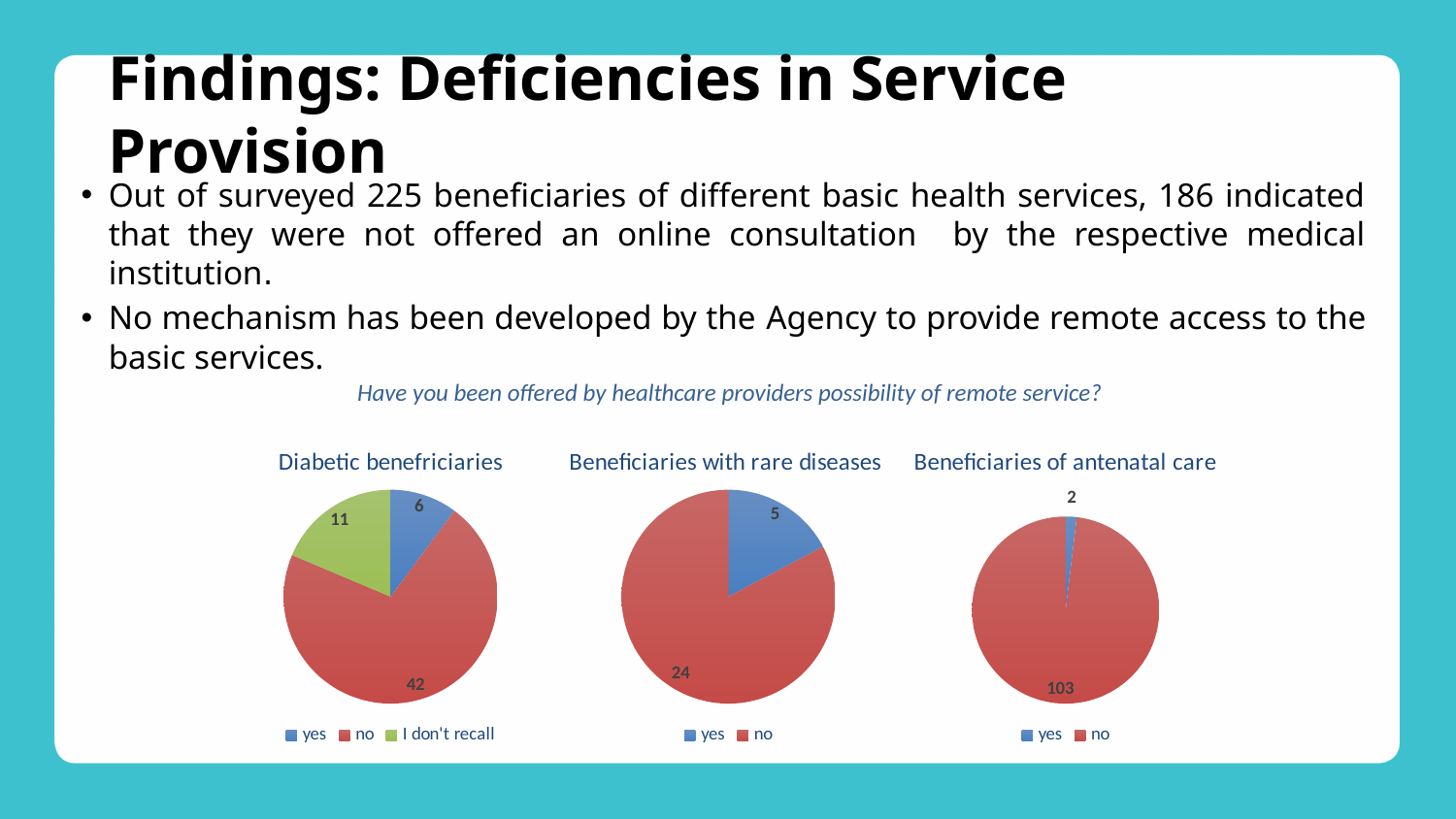
In the 'Diabetic benefriciaries' pie chart, which category has the smallest slice? yes In the 'Diabetic benefriciaries' pie chart, how many respondents answered 'I don't recall'? 11 How many entries does the legend of the 'Beneficiaries with rare diseases' chart list? 2 In the 'Diabetic benefriciaries' pie chart, how many respondents answered 'no'? 42 In the 'Diabetic benefriciaries' pie chart, which is larger: 'I don't recall' or 'yes'? I don't recall What colour represents 'no' in the three pie charts? Red In the 'Beneficiaries with rare diseases' pie chart, what is the value for 'yes'? 5 In the 'Beneficiaries of antenatal care' pie chart, what is the value for 'no'? 103 What type of chart is used for 'Beneficiaries of antenatal care'? Pie chart In the 'Beneficiaries with rare diseases' pie chart, which category has the largest slice? no In the 'Beneficiaries of antenatal care' pie chart, what is the difference between the 'no' and 'yes' values? 101 How many slices does the 'Diabetic benefriciaries' pie chart have? 3